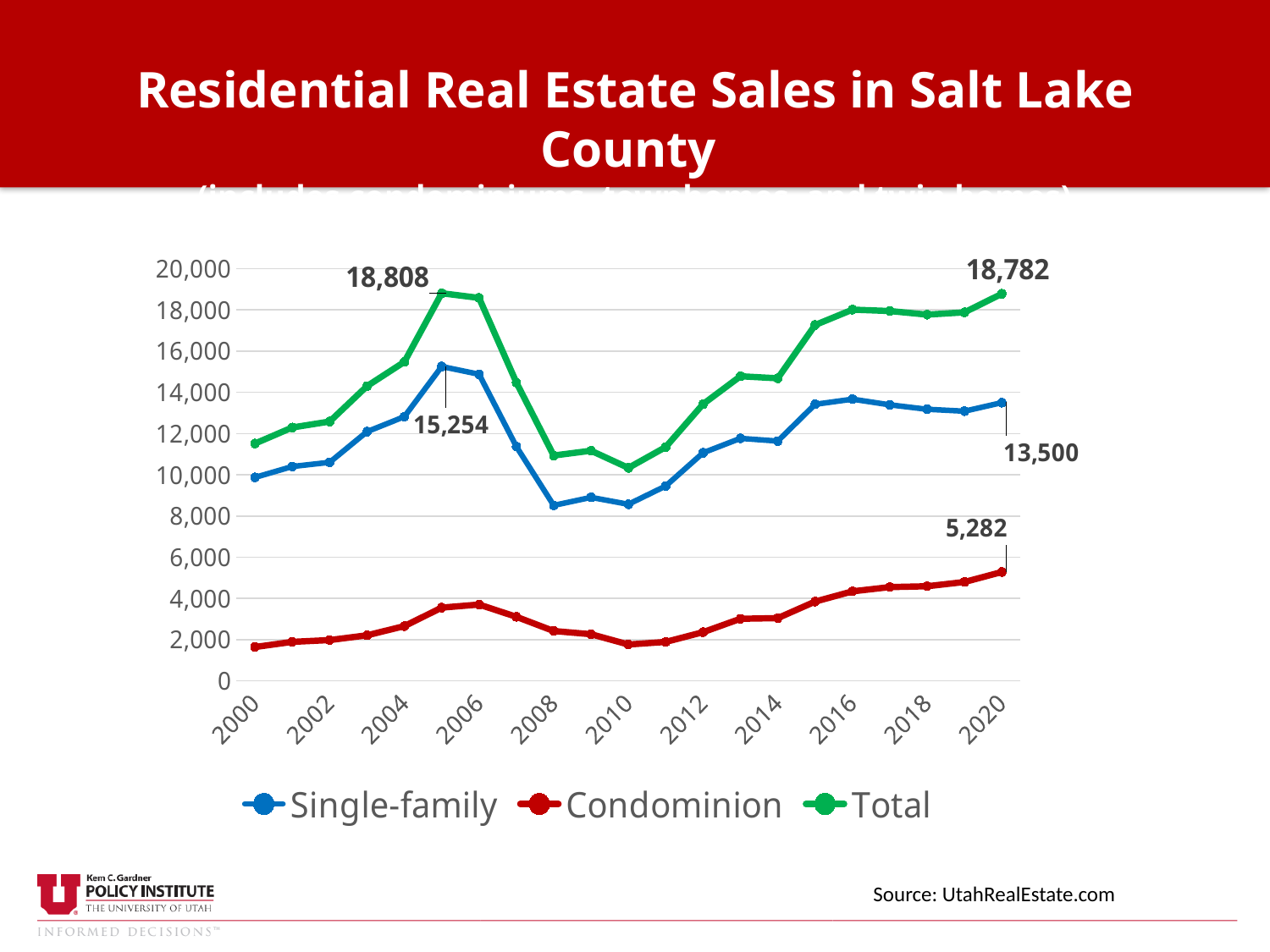
How much higher is the Total value in 2005 (18,808) than in 2020 (18,782)? 26 What is the difference between the Total value and the Single-family value in 2020? 5,282 Is the Total value in 2000 greater or less than 10,000? greater What is the value of the Condominion series in 2020? 5,282 What is the value of the Total series in 2020? 18,782 Is the Single-family value in 2010 greater or less than 10,000? less How many series does the legend list? 3 Which is larger, the Total value in 2005 or the Total value in 2020? 2005 What is the labelled peak value of the Single-family series in 2005? 15,254 What is the value of the Single-family series in 2020? 13,500 What kind of chart is shown on the slide? line chart What is the labelled peak value of the Total series in 2005? 18,808